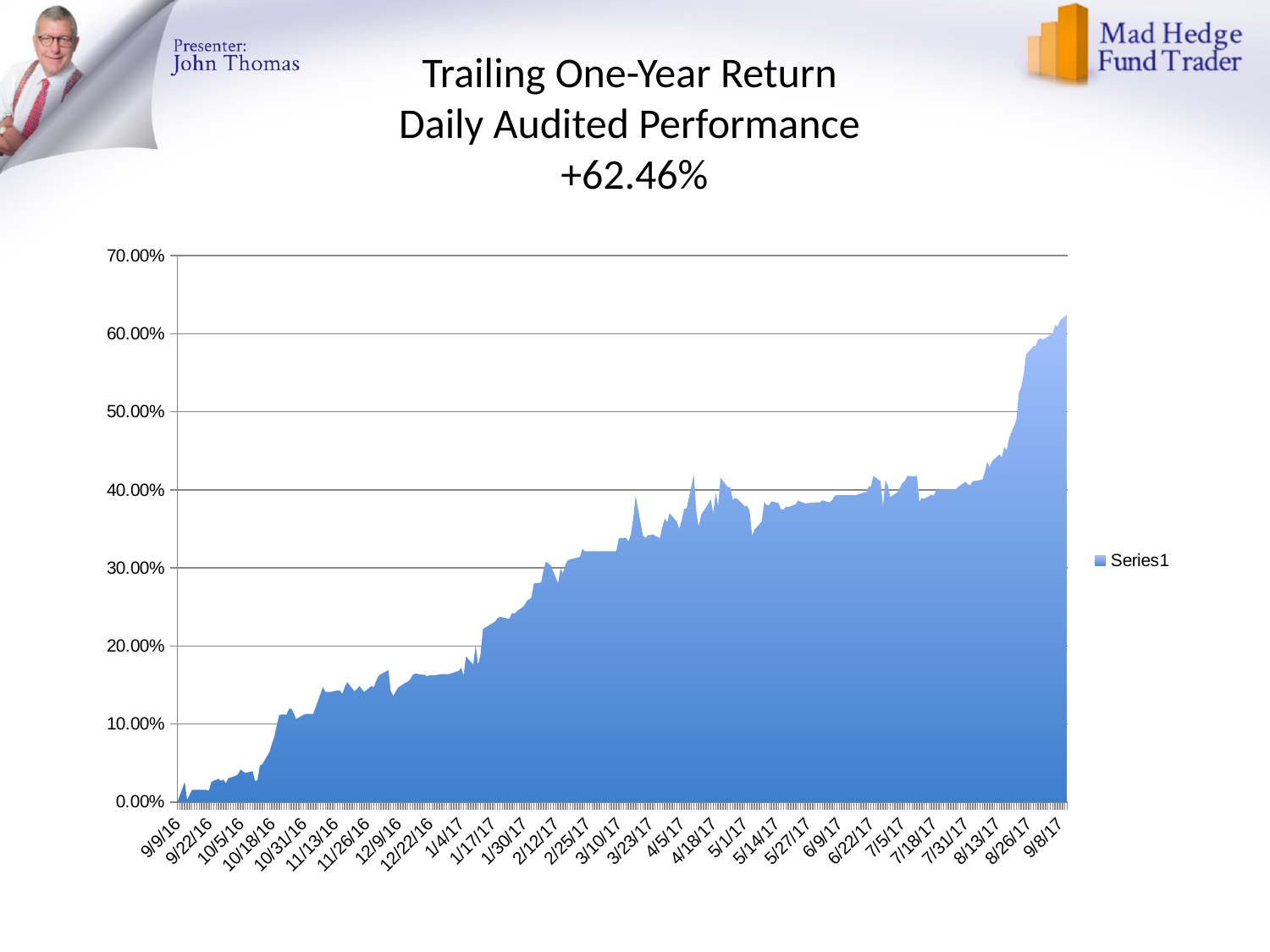
Is the value at 1/4/17 greater or less than 20.00%? less Which date on the x axis has the highest value? 9/8/17 Is the value at 3/10/17 greater or less than 30.00%? greater What kind of chart is shown on the slide? area chart Is the value at 8/26/17 greater or less than 50.00%? greater Which is larger, the value at 9/8/17 or the value at 9/9/16? 9/8/17 How many series does the legend list? 1 What is the name of the series shown in the legend? Series1 Do the values generally rise or fall from 9/9/16 to 9/8/17? rise What return figure is stated in the chart's title? +62.46%